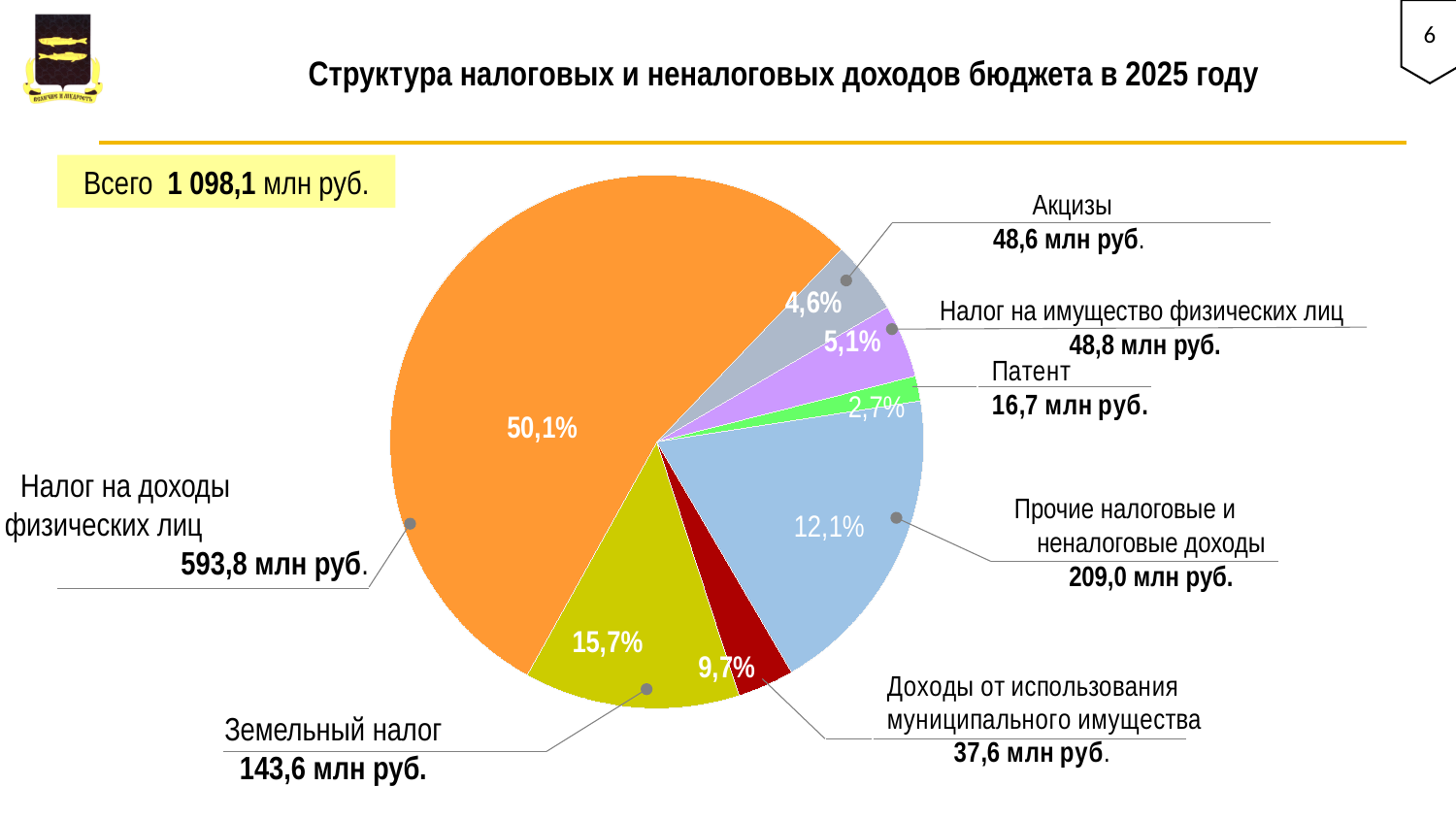
Which category has the smallest value in the pie chart? Патент What type of chart is shown on the slide? pie chart What total amount (Всего) is stated on the slide? 1 098,1 млн руб. What is the value shown for Налог на доходы физических лиц? 593,8 млн руб. What percentage share is labelled on the slice for Налог на доходы физических лиц? 50,1% What is the value shown for Земельный налог? 143,6 млн руб. What is the value shown for Патент? 16,7 млн руб. How many slices (categories) does the pie chart have? 7 What is the value shown for Прочие налоговые и неналоговые доходы? 209,0 млн руб. What is the difference between Прочие налоговые и неналоговые доходы and Земельный налог? 65,4 млн руб. Which is larger: Земельный налог or Прочие налоговые и неналоговые доходы? Прочие налоговые и неналоговые доходы Which category has the largest value in the pie chart? Налог на доходы физических лиц